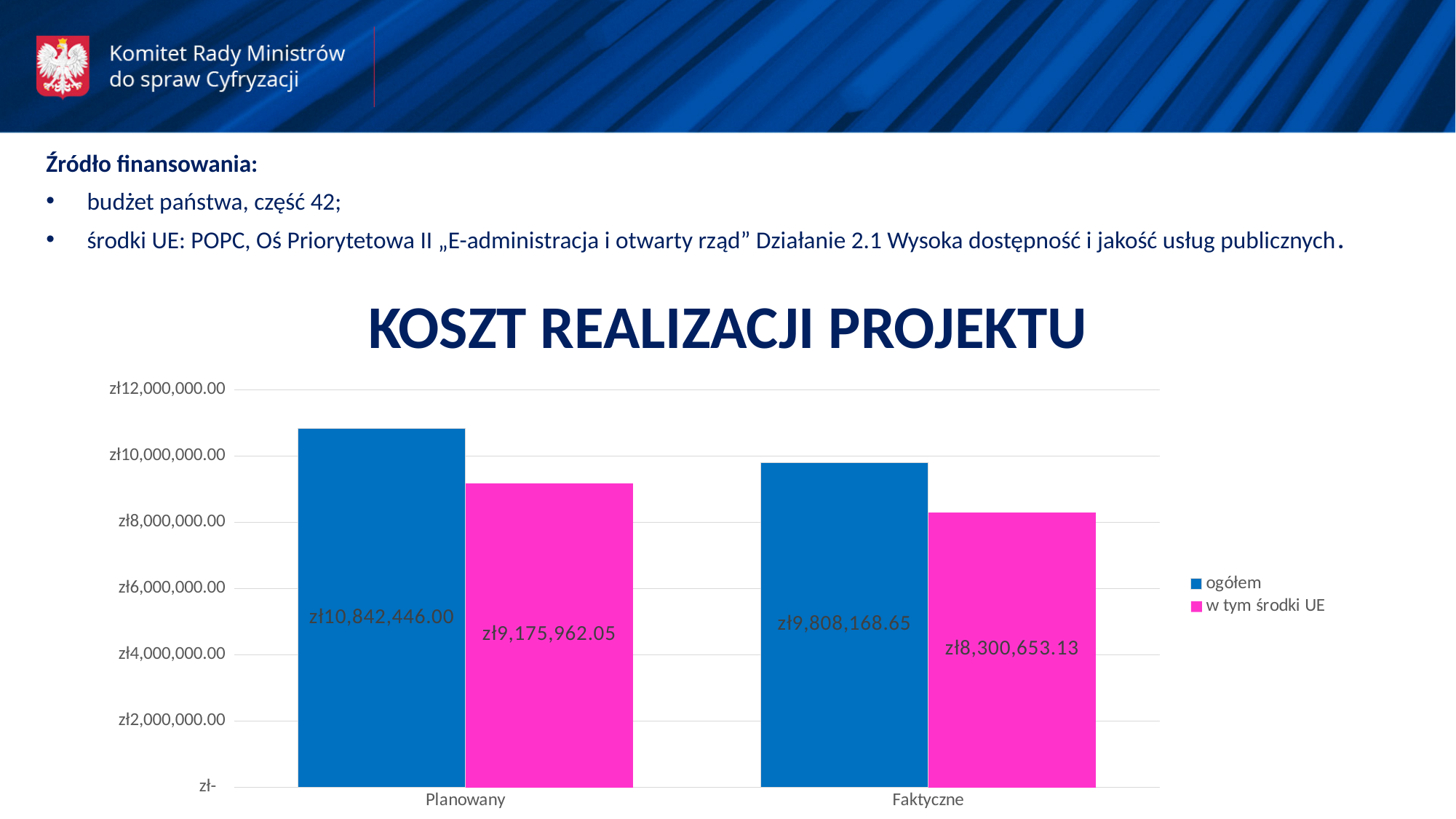
What is the difference between the ogółem values for Planowany and Faktyczne? zł1,034,277.35 How many series does the legend list? 2 What is the value of w tym środki UE for Planowany? zł9,175,962.05 What is the value of ogółem for Planowany? zł10,842,446.00 Which category has the highest ogółem value? Planowany How many categories are shown on the x axis? 2 What is the difference between ogółem and w tym środki UE for Faktyczne? zł1,507,515.52 Which is larger: w tym środki UE for Planowany or ogółem for Faktyczne? ogółem for Faktyczne What type of chart is shown on the slide? bar chart What is the value of ogółem for Faktyczne? zł9,808,168.65 What is the value of w tym środki UE for Faktyczne? zł8,300,653.13 Which category has the lowest w tym środki UE value? Faktyczne